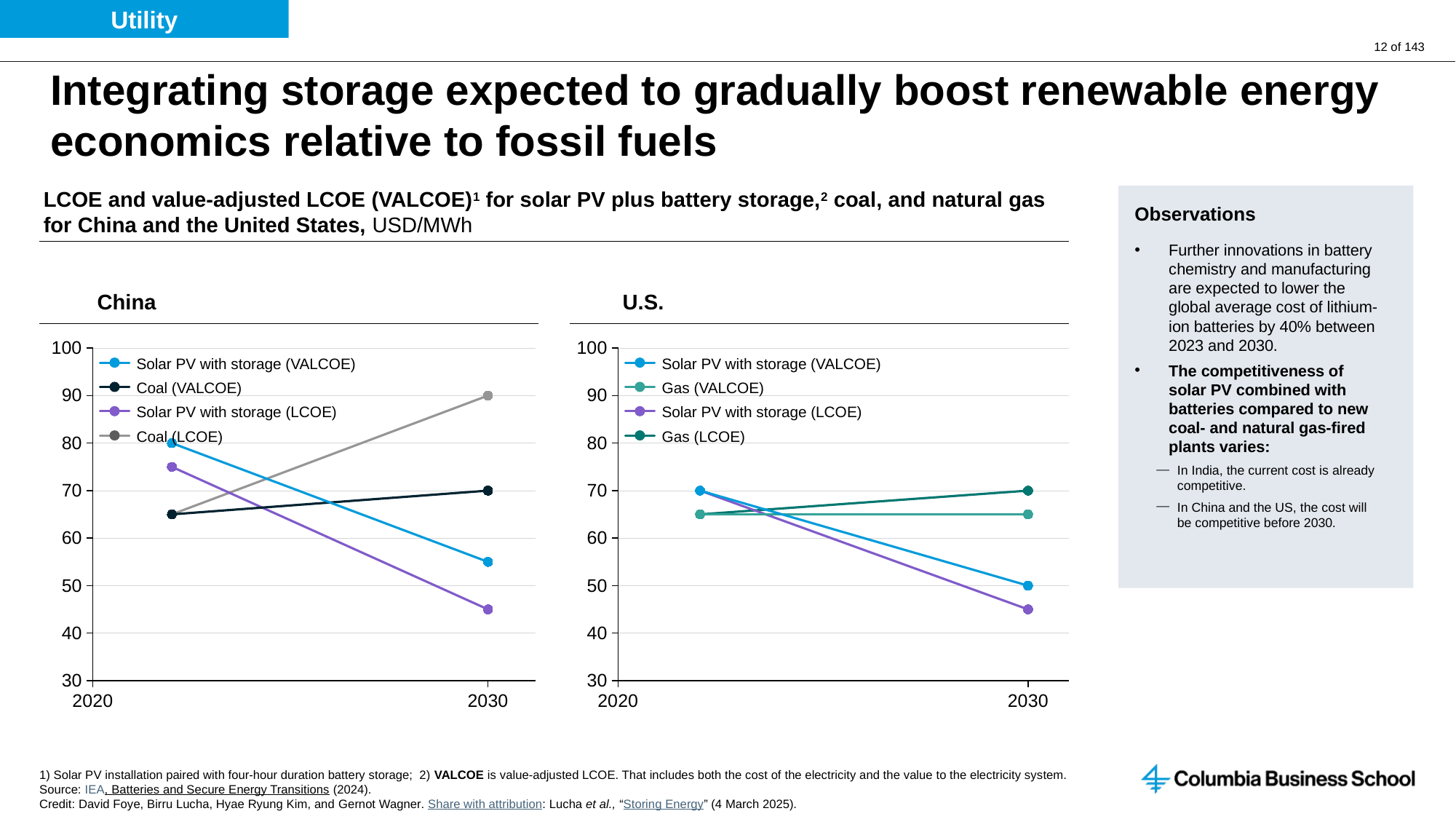
In the China chart, is the value for Solar PV with storage (VALCOE) in 2030 greater or less than 60? less How many series does the legend of the U.S. chart list? 4 In the U.S. chart, which series has the lowest value in 2030? Solar PV with storage (LCOE) In the U.S. chart, which is larger in 2030: Gas (LCOE) or Gas (VALCOE)? Gas (LCOE) In the China chart, what is the value for Coal (LCOE) in 2030? 90 In the China chart, does the Solar PV with storage (LCOE) line rise or fall toward 2030? fall In the China chart, which series has the highest value in 2030? Coal (LCOE) In the China chart, what is the value for Coal (VALCOE) in 2030? 70 In the U.S. chart, what is the value for Gas (LCOE) in 2030? 70 In the U.S. chart, what is the value for Solar PV with storage (VALCOE) in 2030? 50 What kind of chart is the China chart? line chart In the China chart, what is the difference between Coal (LCOE) and Coal (VALCOE) in 2030? 20